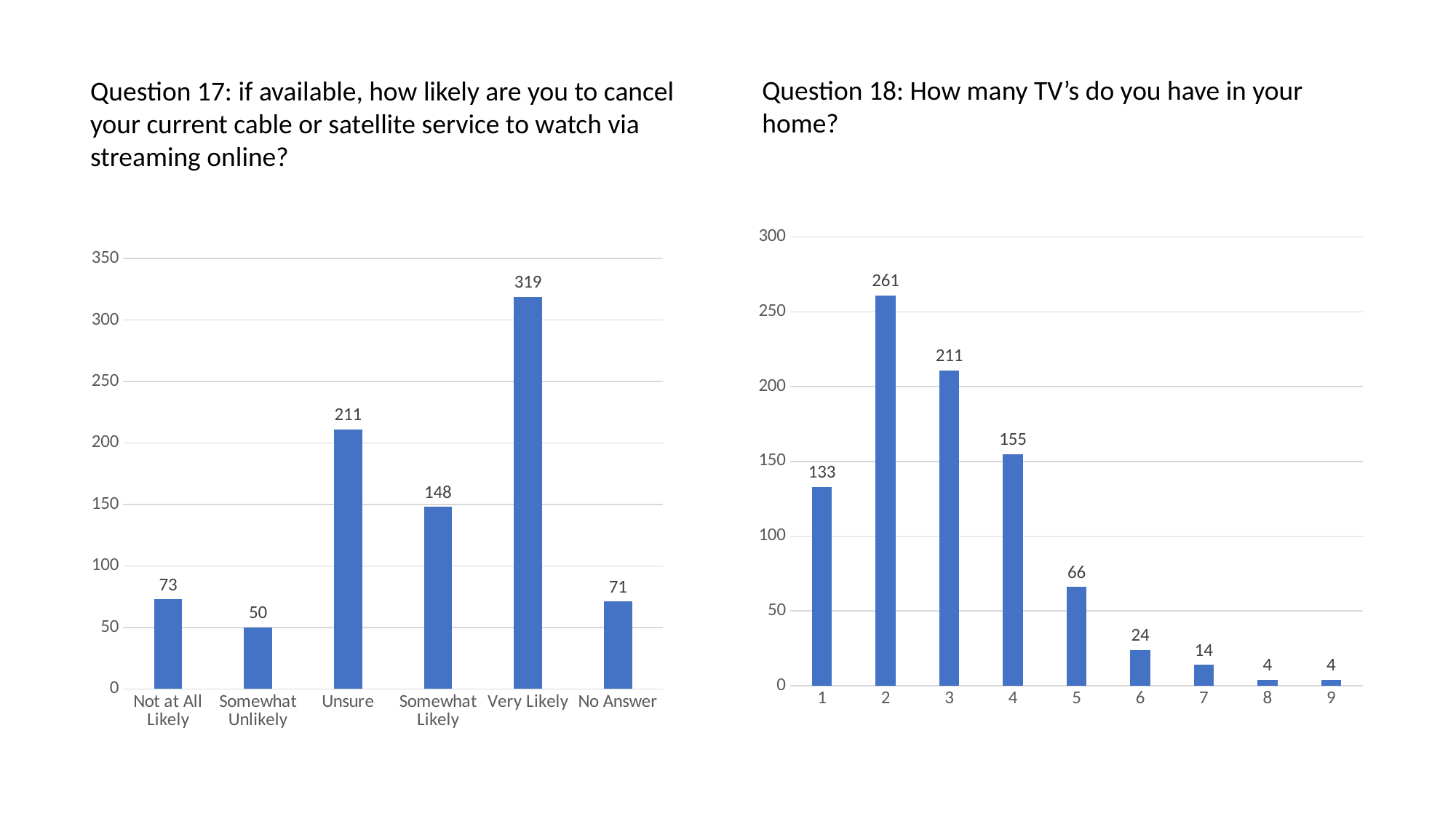
In the Question 17 chart on the left, which category has the lowest value? Somewhat Unlikely In the Question 17 chart on the left, what is the value for Very Likely? 319 In the Question 18 chart on the right, which category has the highest value? 2 In the Question 17 chart on the left, which is larger, Not at All Likely or No Answer? Not at All Likely What type of chart is the Question 18 chart on the right? bar chart In the Question 18 chart on the right, how many categories are shown on the x axis? 9 In the Question 17 chart on the left, what is the value for Somewhat Unlikely? 50 In the Question 18 chart on the right, what is the difference between the values for 1 and 4? 22 In the Question 18 chart on the right, what is the value for 2 TVs? 261 In the Question 17 chart on the left, what is the difference between Very Likely and Unsure? 108 In the Question 18 chart on the right, do the values rise or fall from category 2 to category 9? fall In the Question 17 chart on the left, how many categories are shown on the x axis? 6